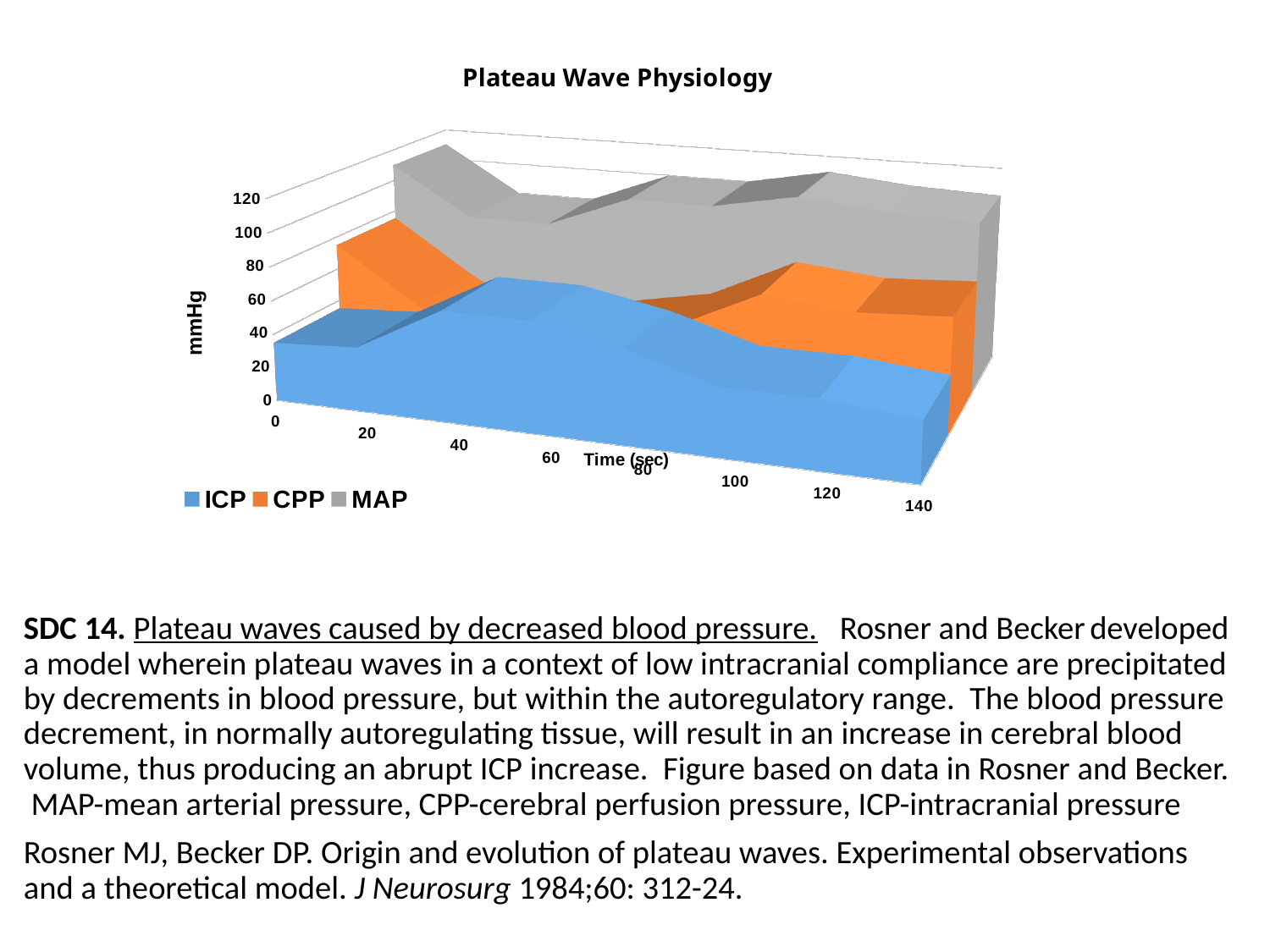
Is the value for ICP at time 0 greater or less than 100? less Does the ICP series rise or fall between 60 and 140 seconds? fall How many time points are labelled on the x axis? 8 What kind of chart is shown on the slide? area chart How many series does the legend list? 3 Is the value for ICP at time 140 greater or less than 100? less What are the three series named in the legend? ICP, CPP, MAP What is the title of the chart? Plateau Wave Physiology Does the ICP series rise or fall between 0 and 60 seconds? rise